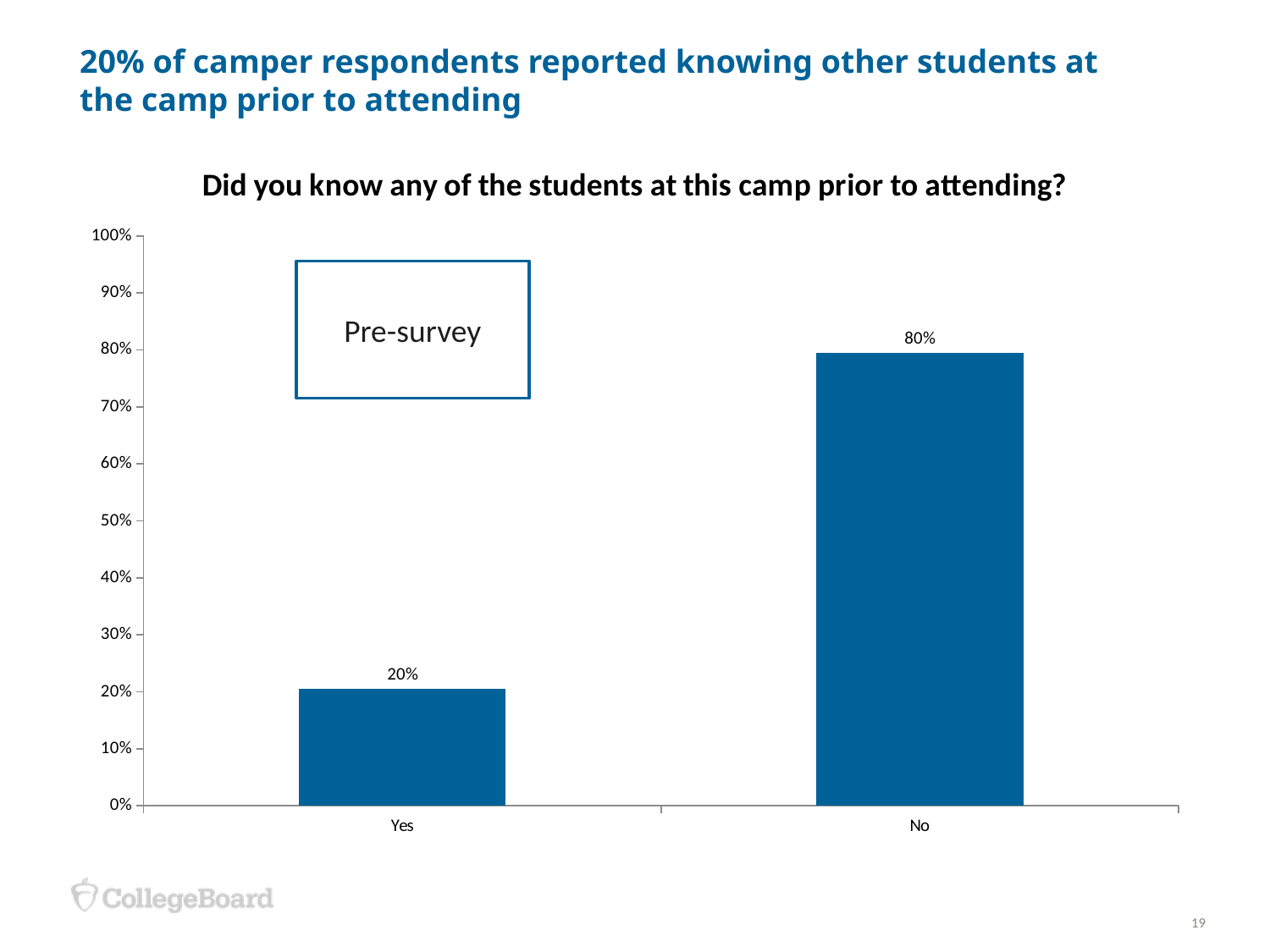
What kind of chart is shown on the slide? Bar chart Which response category has the lowest value? Yes What is the title of the chart? Did you know any of the students at this camp prior to attending? What is the difference between the "No" and "Yes" percentages? 60% Is the value for "No" greater or less than 50%? greater How many response categories are shown on the x axis? 2 What label appears in the box inside the chart area? Pre-survey Which is larger, the value for "Yes" or the value for "No"? No What percentage of respondents answered "Yes"? 20% What percentage of respondents answered "No"? 80% Which response category has the highest value? No Is the value for "Yes" greater or less than 30%? less